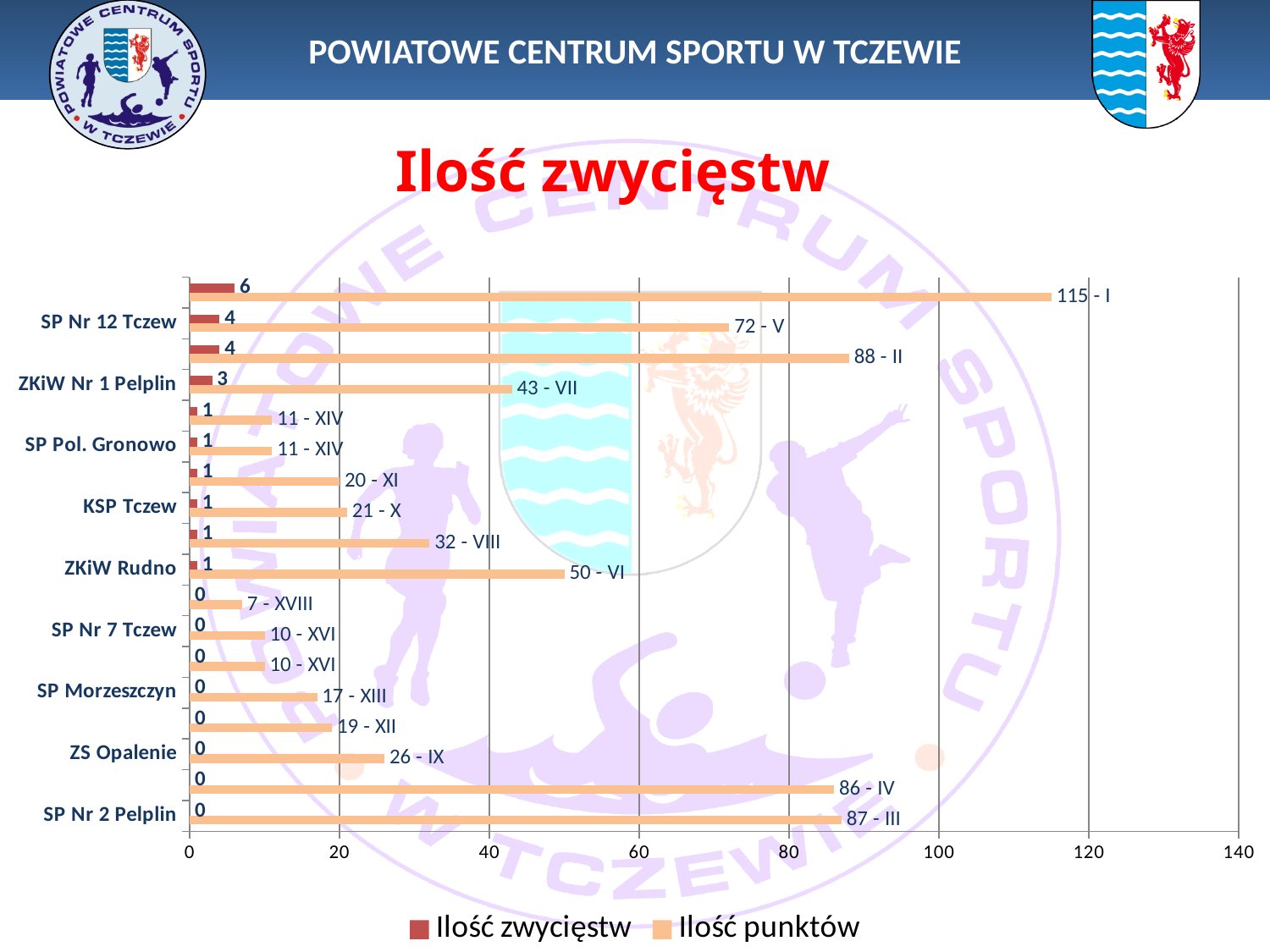
What is the Ilość punktów data label for SP Nr 2 Pelplin? 87 - III Which has more Ilość punktów, SP Nr 12 Tczew or ZKiW Nr 1 Pelplin? SP Nr 12 Tczew Is the Ilość punktów value for ZKiW Rudno greater or less than 40? greater What is the Ilość punktów data label for SP Nr 12 Tczew? 72 - V What is the highest Ilość punktów data label shown in the chart? 115 - I What is the Ilość zwycięstw value for KSP Tczew? 1 What is the highest Ilość zwycięstw value shown in the chart? 6 What kind of chart is shown on the slide? bar chart What is the difference in Ilość punktów between SP Nr 2 Pelplin (87) and ZS Opalenie (26)? 61 What are the two series named in the legend? Ilość zwycięstw and Ilość punktów How many series does the legend list? 2 What is the Ilość zwycięstw value for ZKiW Nr 1 Pelplin? 3